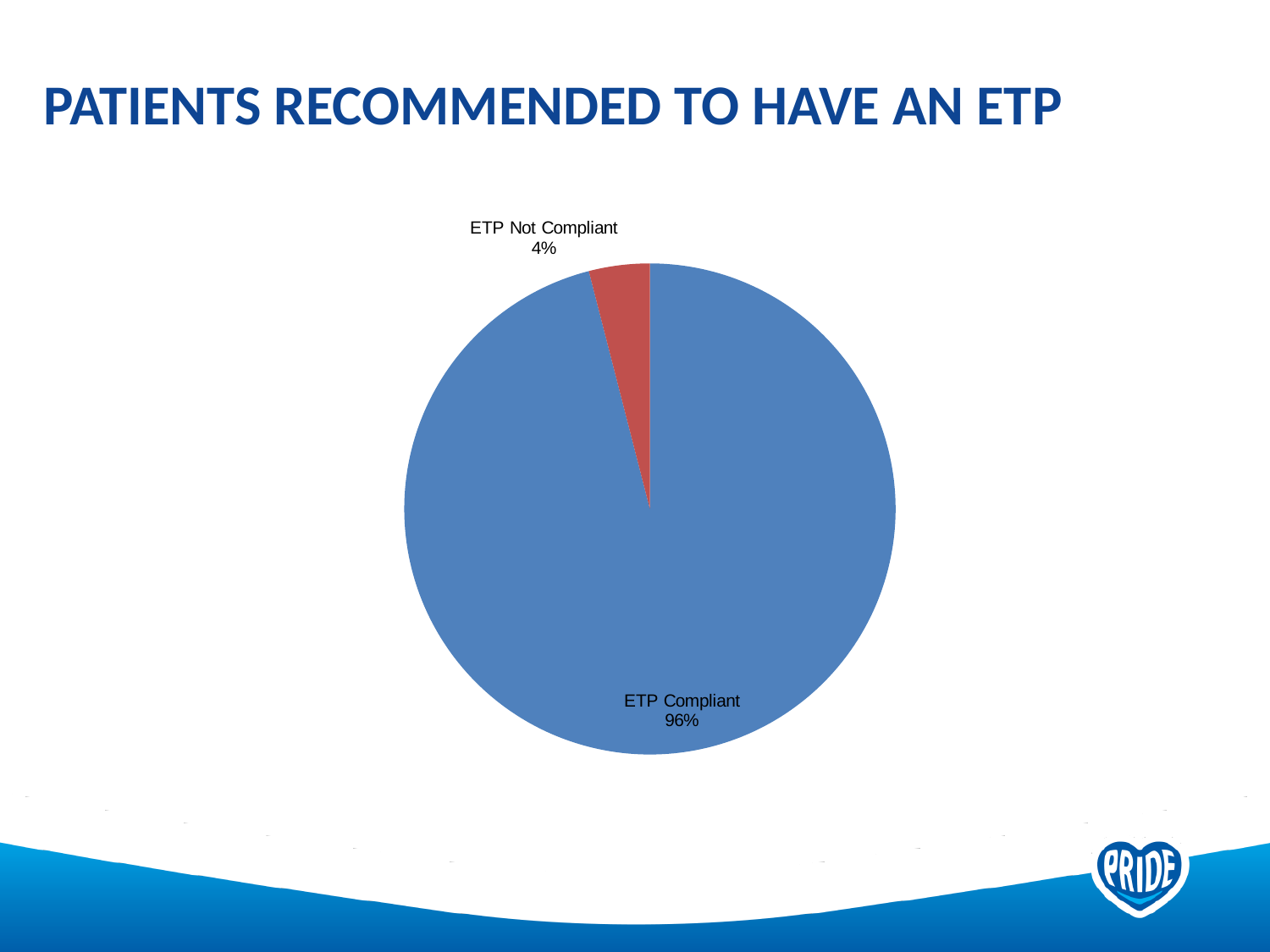
What kind of chart is shown on the slide? pie chart What is the difference in percentage points between ETP Compliant and ETP Not Compliant? 92 Which slice of the pie is the largest? ETP Compliant What percentage of patients are ETP Compliant? 96% What colour is the ETP Not Compliant slice? red What percentage of patients are ETP Not Compliant? 4% What is the title of the slide containing the pie chart? PATIENTS RECOMMENDED TO HAVE AN ETP Which slice of the pie is the smallest? ETP Not Compliant Which is larger, the ETP Compliant slice or the ETP Not Compliant slice? ETP Compliant How many slices does the pie chart have? 2 What share of the pie does the ETP Not Compliant slice represent? 4%